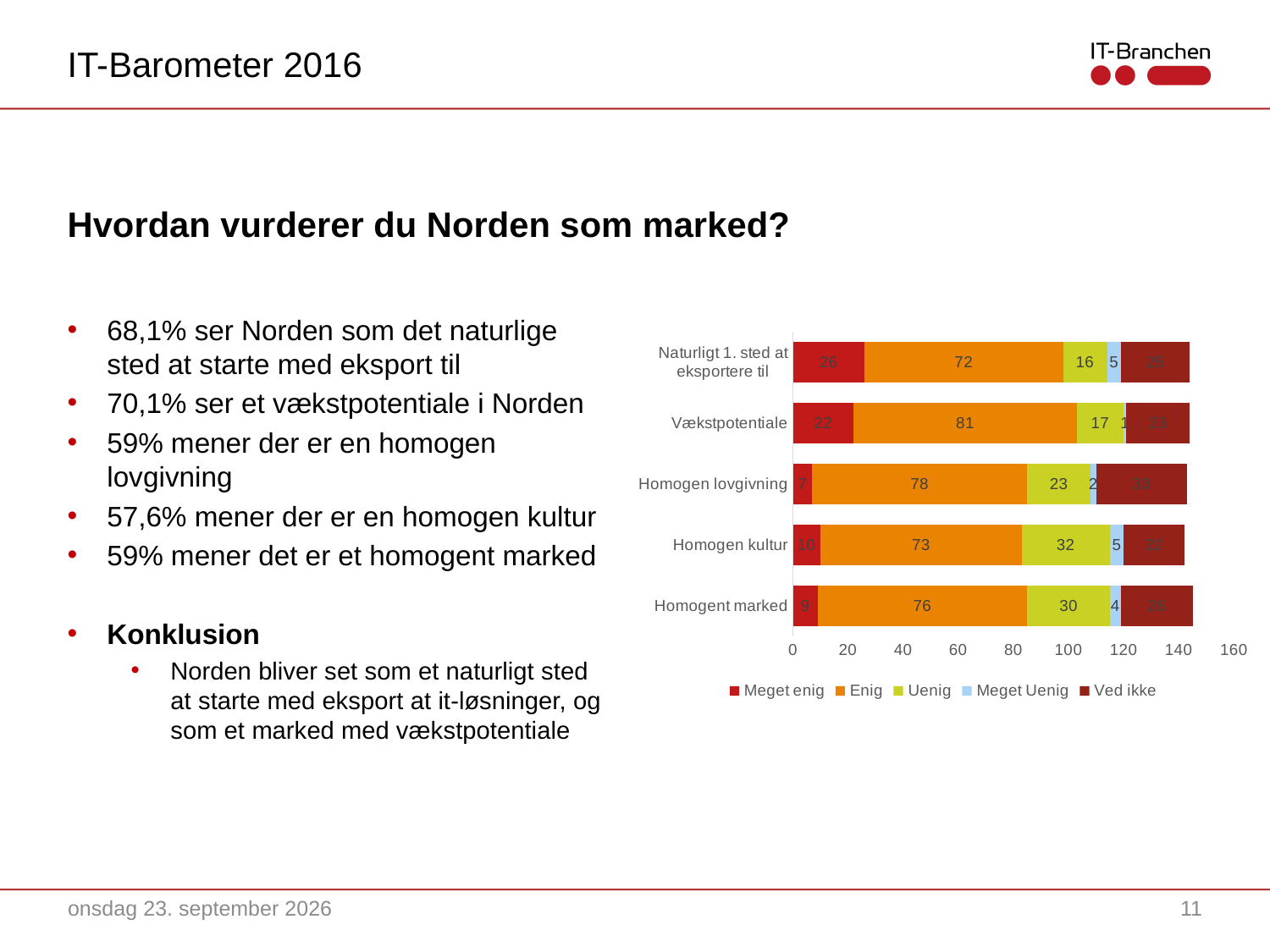
Which is larger: the "Uenig" value for "Homogen kultur" or for "Homogen lovgivning"? Homogen kultur Which series is shown in orange in the legend? Enig Which category has the highest "Enig" value? Vækstpotentiale How many series does the legend list? 5 What is the value of the "Meget Uenig" segment for "Homogent marked"? 4 How many categories are shown on the chart? 5 What is the value of the "Meget enig" segment for "Naturligt 1. sted at eksportere til"? 26 What is the value of the "Uenig" segment for "Homogen kultur"? 32 Which category has the lowest "Meget enig" value? Homogen lovgivning What kind of chart is shown on the slide? Stacked bar chart What is the value of the "Enig" segment for "Vækstpotentiale"? 81 What is the difference between the "Enig" values for "Vækstpotentiale" and "Naturligt 1. sted at eksportere til"? 9